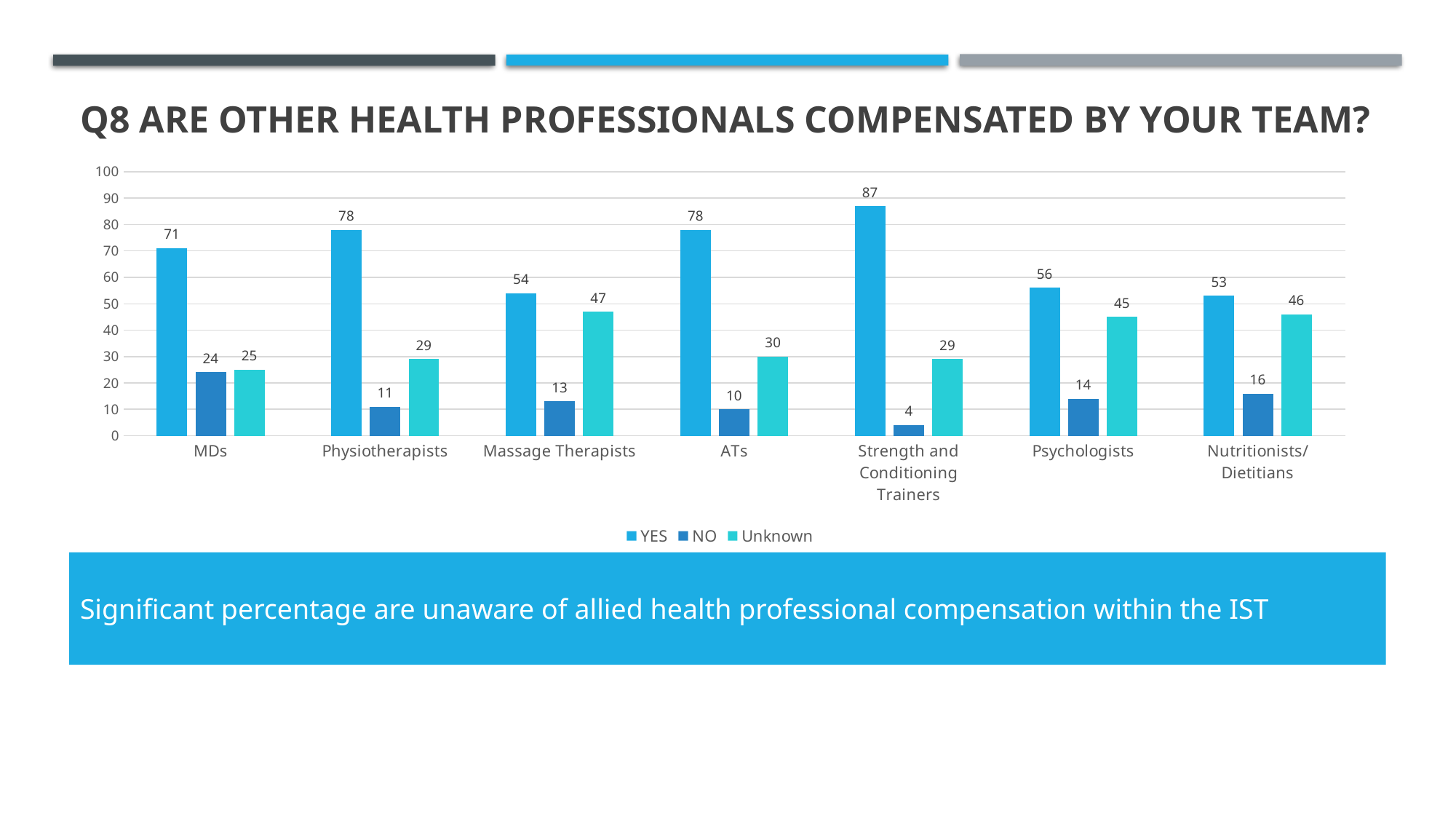
What is the Unknown value for Massage Therapists? 47 Is the YES value for Nutritionists/Dietitians greater or less than 50? greater How many categories are shown on the x axis? 7 What kind of chart is shown on the slide? Bar chart How many series does the legend list? 3 What are the three series listed in the legend? YES, NO, Unknown Which is larger for MDs: the NO value or the Unknown value? Unknown What is the YES value for Strength and Conditioning Trainers? 87 What is the difference between the YES and Unknown values for Psychologists? 11 What is the NO value for ATs? 10 Which category has the highest YES value? Strength and Conditioning Trainers Which category has the lowest NO value? Strength and Conditioning Trainers